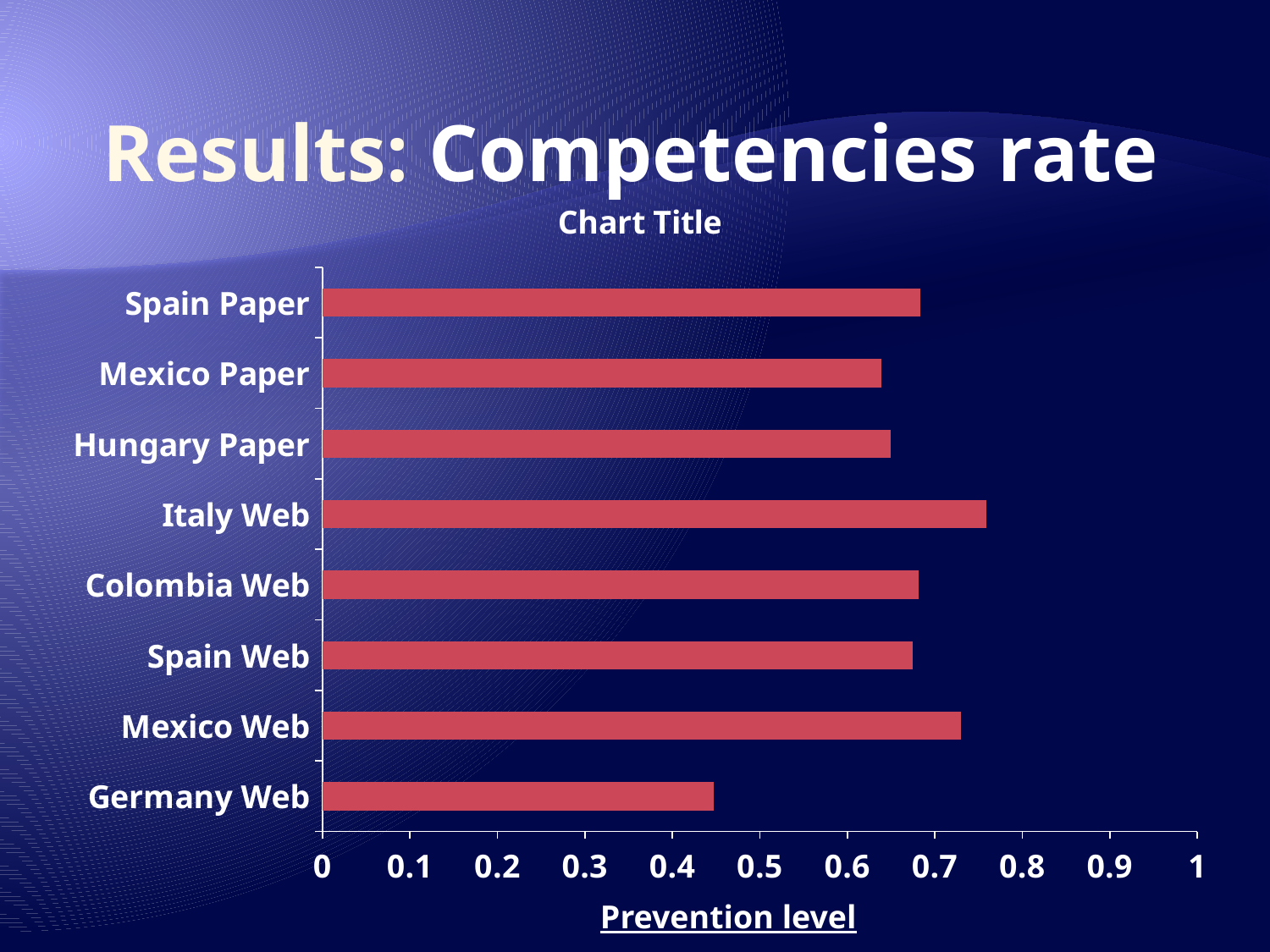
What is the label of the horizontal axis of the chart? Prevention level Is the value for Mexico Paper greater or less than 0.6? greater Which has the larger value, Mexico Web or Spain Web? Mexico Web Is the value for Spain Paper greater or less than 0.7? less Is the value for Italy Web greater or less than 0.7? greater How many categories are plotted in the chart? 8 Which category has the lowest value in the chart? Germany Web What is the title shown above the chart? Chart Title Which has the larger value, Italy Web or Germany Web? Italy Web Which category has the highest value in the chart? Italy Web What kind of chart is shown on the slide? bar chart